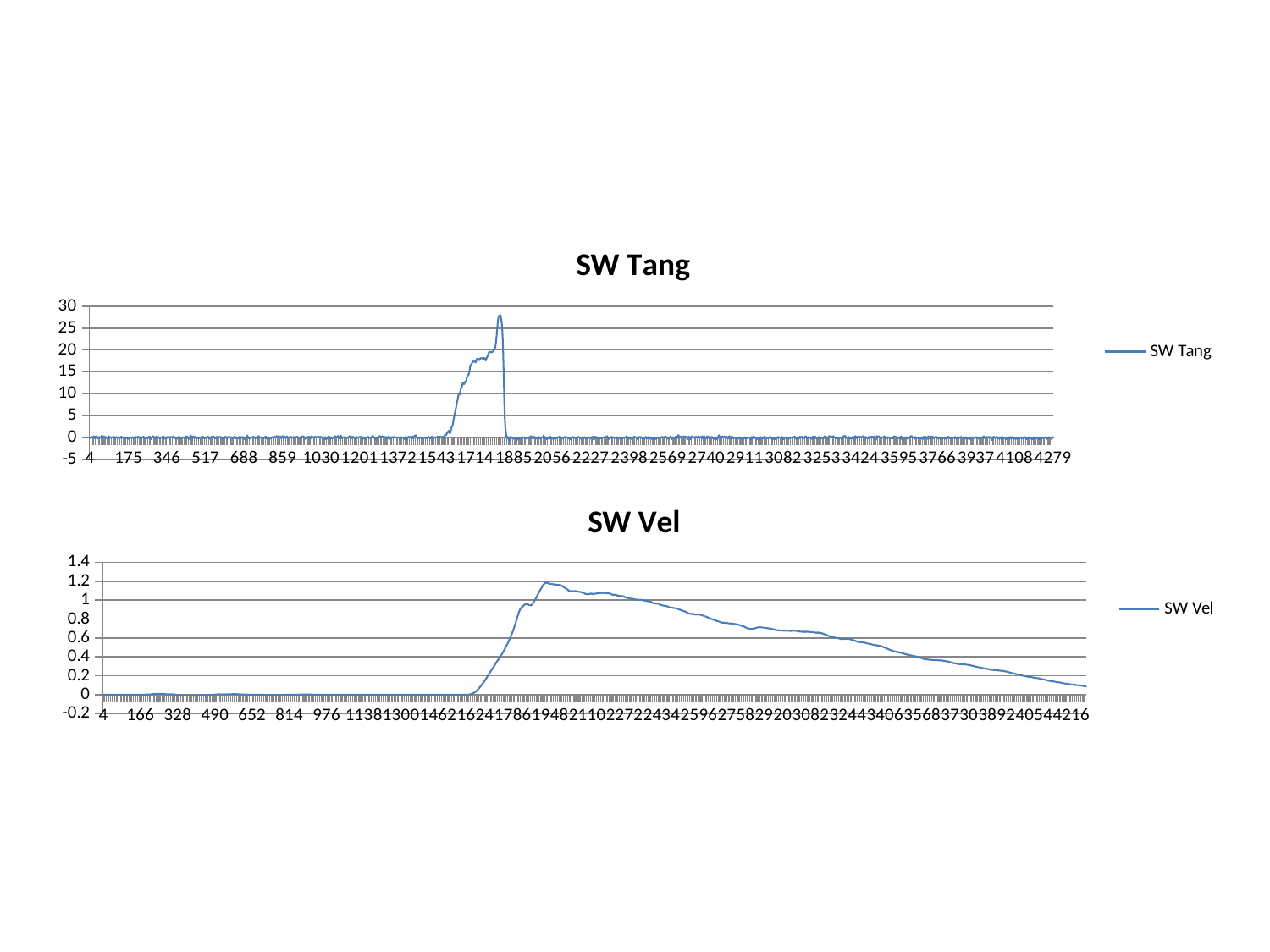
How many series does the legend of the "SW Tang" chart list? 1 In the "SW Vel" chart, is the value at the last x-axis label 4216 greater or less than 0.2? less In the "SW Tang" chart, is the value at the last x-axis label 4279 greater or less than 5? less In the "SW Vel" chart, after reaching its peak, does the line rise or fall as x increases? fall What is the legend entry shown for the bottom chart? SW Vel What kind of chart is the "SW Tang" chart? line chart In the "SW Vel" chart, is the peak value of the line greater or less than 1? greater What is the title of the top chart on the slide? SW Tang How many series does the legend of the "SW Vel" chart list? 1 What kind of chart is the "SW Vel" chart? line chart